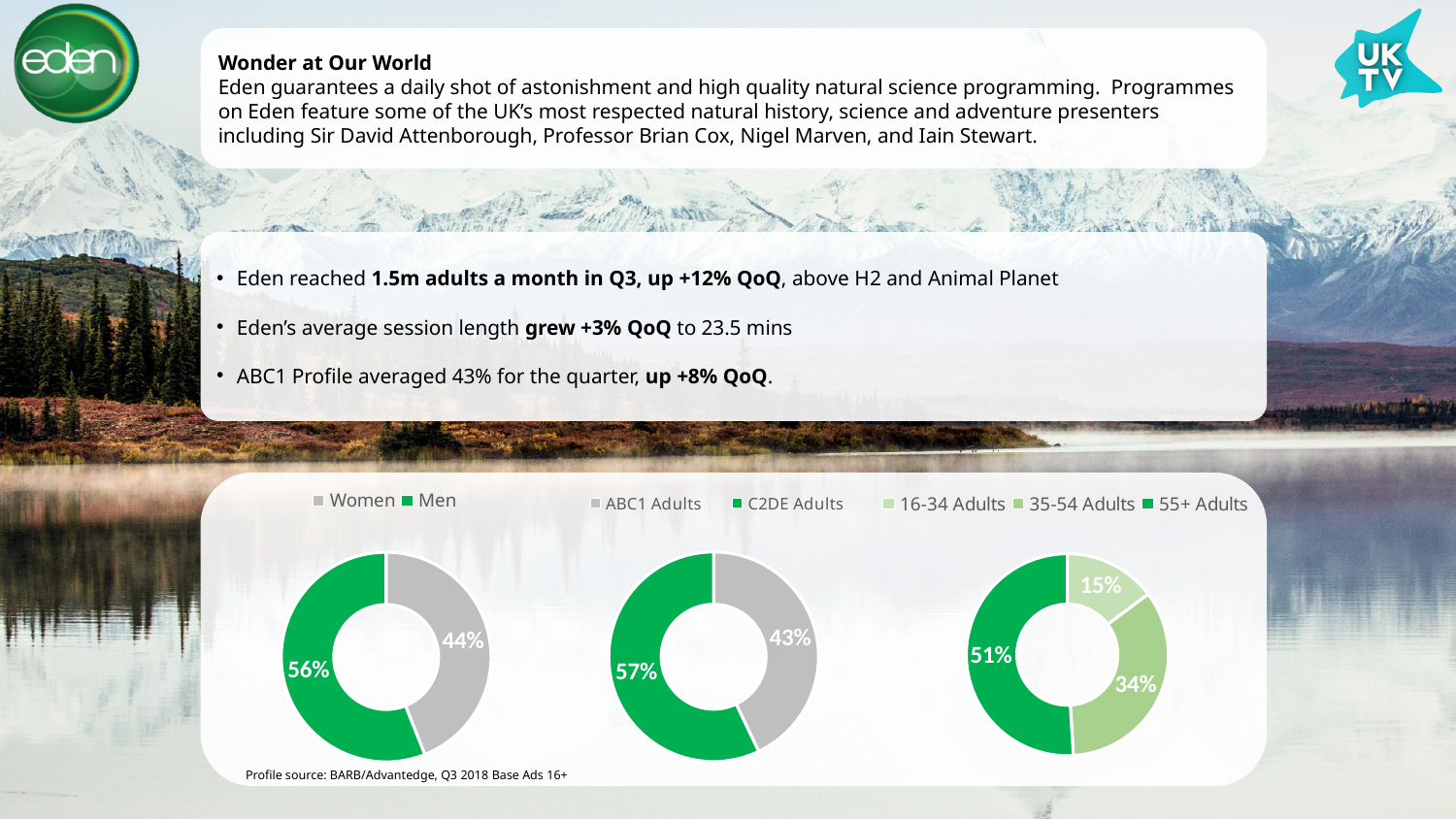
In the right-hand donut chart, what share is labelled for 16-34 Adults? 15% In the middle donut chart, what share is labelled for C2DE Adults? 57% In the left-hand donut chart, which segment is larger, Women or Men? Men In the right-hand donut chart, what share is labelled for 35-54 Adults? 34% In the left-hand donut chart, what share is labelled for Women? 44% In the left-hand donut chart, what share is labelled for Men? 56% How many segments does the right-hand donut chart's legend list? 3 In the middle donut chart, which segment is larger, ABC1 Adults or C2DE Adults? C2DE Adults In the right-hand donut chart, which age group has the largest share? 55+ Adults In the right-hand donut chart, which age group has the smallest share? 16-34 Adults In the left-hand donut chart, what is the difference between the Men and Women shares? 12% In the middle donut chart, what share is labelled for ABC1 Adults? 43%